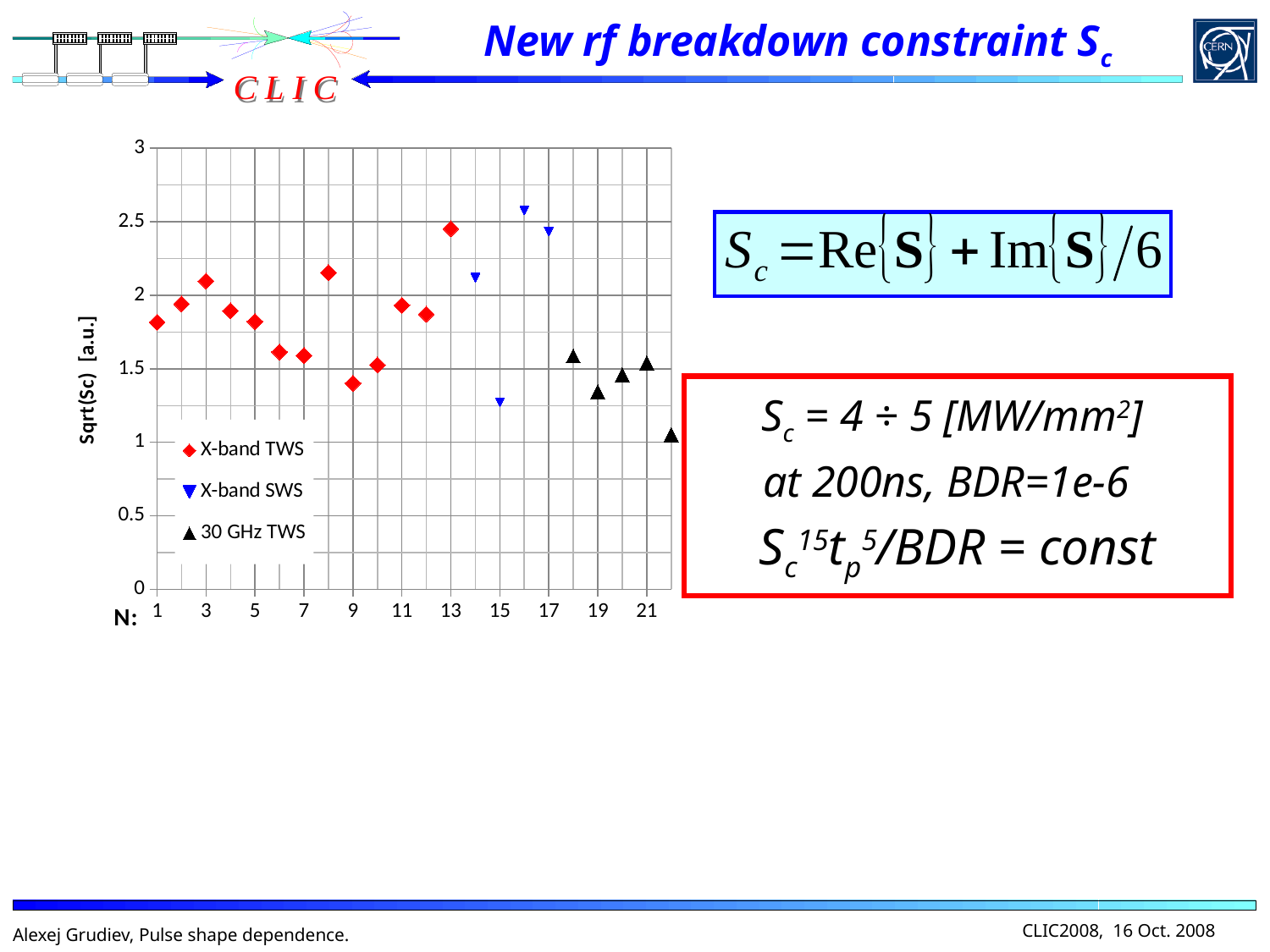
Which series is plotted with red diamond markers? X-band TWS Which has the larger Sqrt(Sc) value, the point at N=1 or the point at N=9? N=1 Is the Sqrt(Sc) value at N=16 greater or less than 2.5? greater Is the Sqrt(Sc) value at N=3 greater or less than 2? greater Is the Sqrt(Sc) value at N=9 greater or less than 1.5? less How many series does the chart legend list? 3 How many data points belong to the 30 GHz TWS series? 5 How many data points belong to the X-band SWS series? 4 What kind of chart is shown on the slide? scatter chart Which series contains the highest Sqrt(Sc) value on the chart? X-band SWS How many data points belong to the X-band TWS series? 13 What is the label of the vertical axis? Sqrt(Sc) [a.u.]